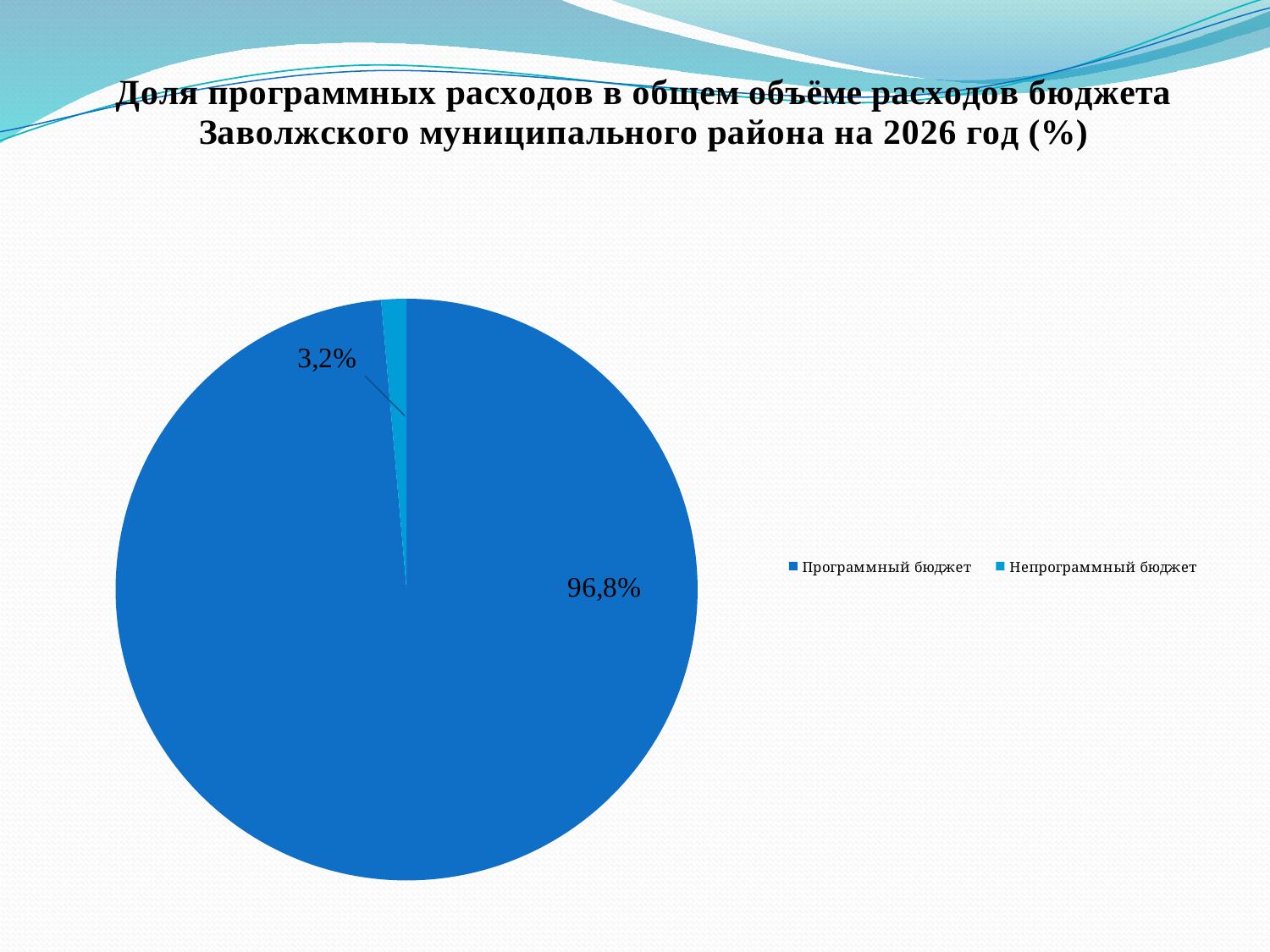
What is the value for Непрограммный бюджет? 3,2% What is the difference between the shares of Программный бюджет and Непрограммный бюджет? 93,6% What is the value for Программный бюджет? 96,8% What is the title of the chart on the slide? Доля программных расходов в общем объёме расходов бюджета Заволжского муниципального района на 2026 год (%) What share of the pie does Непрограммный бюджет take? 3,2% What kind of chart is shown on the slide? pie chart How many entries does the legend list? 2 Which category has the largest share of the pie? Программный бюджет Which legend entry is shown in the lighter blue colour? Непрограммный бюджет Which category has the smallest share of the pie? Непрограммный бюджет How many slices does the pie chart have? 2 Which is larger, the share of Программный бюджет or Непрограммный бюджет? Программный бюджет